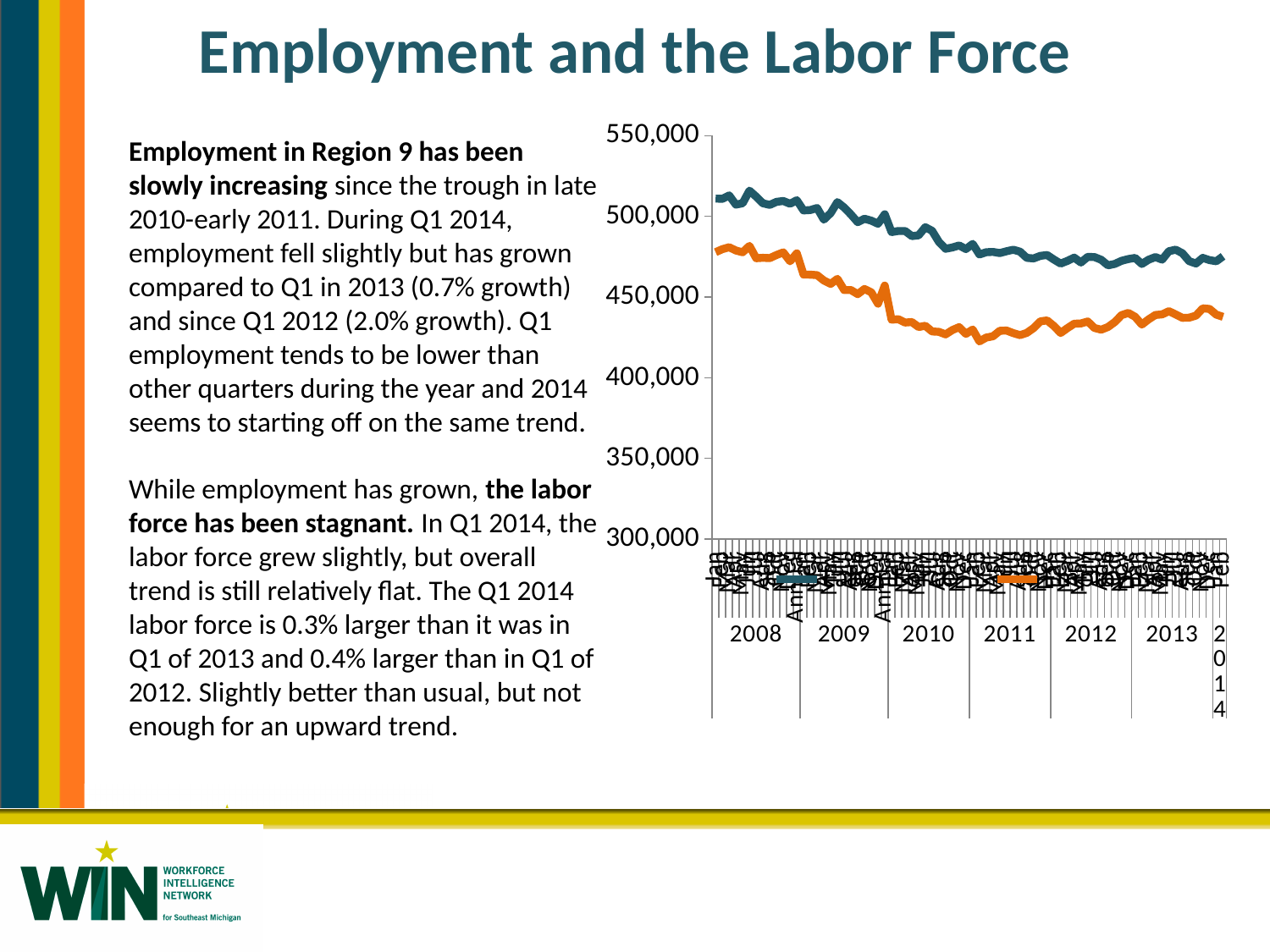
What is the highest value shown on the y axis of the chart? 550,000 Is the value of the lower (orange) line at the start of 2008 greater or less than 450,000? greater How many lines are plotted on the chart? 2 How many year labels appear along the x axis of the chart? 7 What kind of chart is shown on the slide? line chart Is the value of the lower (orange) line during 2011 greater or less than 450,000? less Is the value of the upper (blue) line during 2013 greater or less than 500,000? less Which year is the first labelled on the x axis of the chart? 2008 Does the orange line rise or fall from 2008 to 2011? fall Does the blue line rise or fall from 2008 to 2011? fall Which line is higher throughout the chart, the blue line or the orange line? the blue line